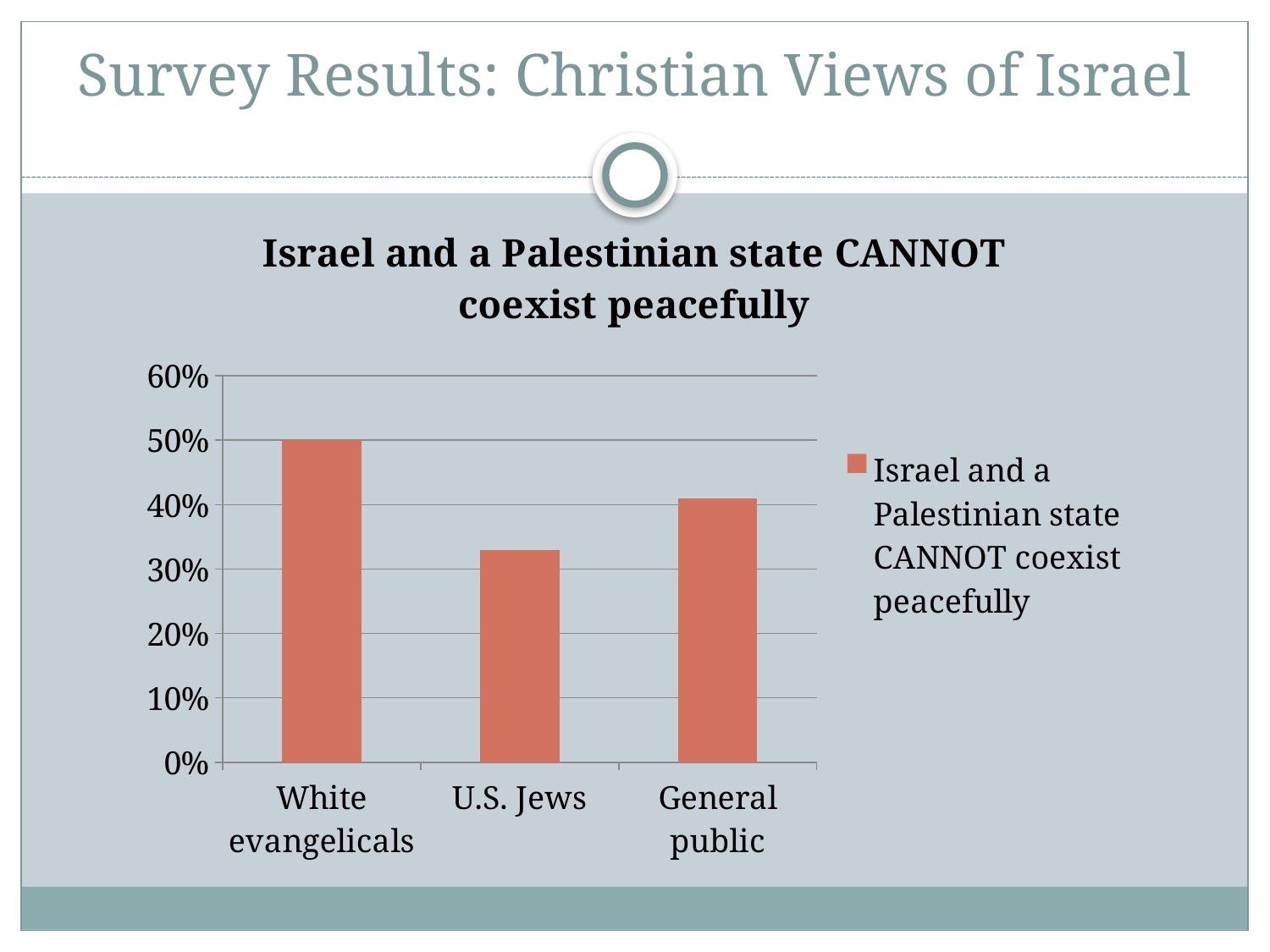
Which category has the lowest value in the chart? U.S. Jews How many series does the chart's legend list? 1 What is the value for White evangelicals? 50% Is the value for General public greater or less than 50%? less Is the value for U.S. Jews greater or less than 30%? greater What is the title of the chart? Israel and a Palestinian state CANNOT coexist peacefully What kind of chart is shown on the slide? bar chart What is the highest value shown on the chart's y axis? 60% Is the value for U.S. Jews greater or less than 40%? less Which category has the highest value in the chart? White evangelicals How many categories are shown on the x axis of the chart? 3 Which is larger, the value for General public or the value for U.S. Jews? General public